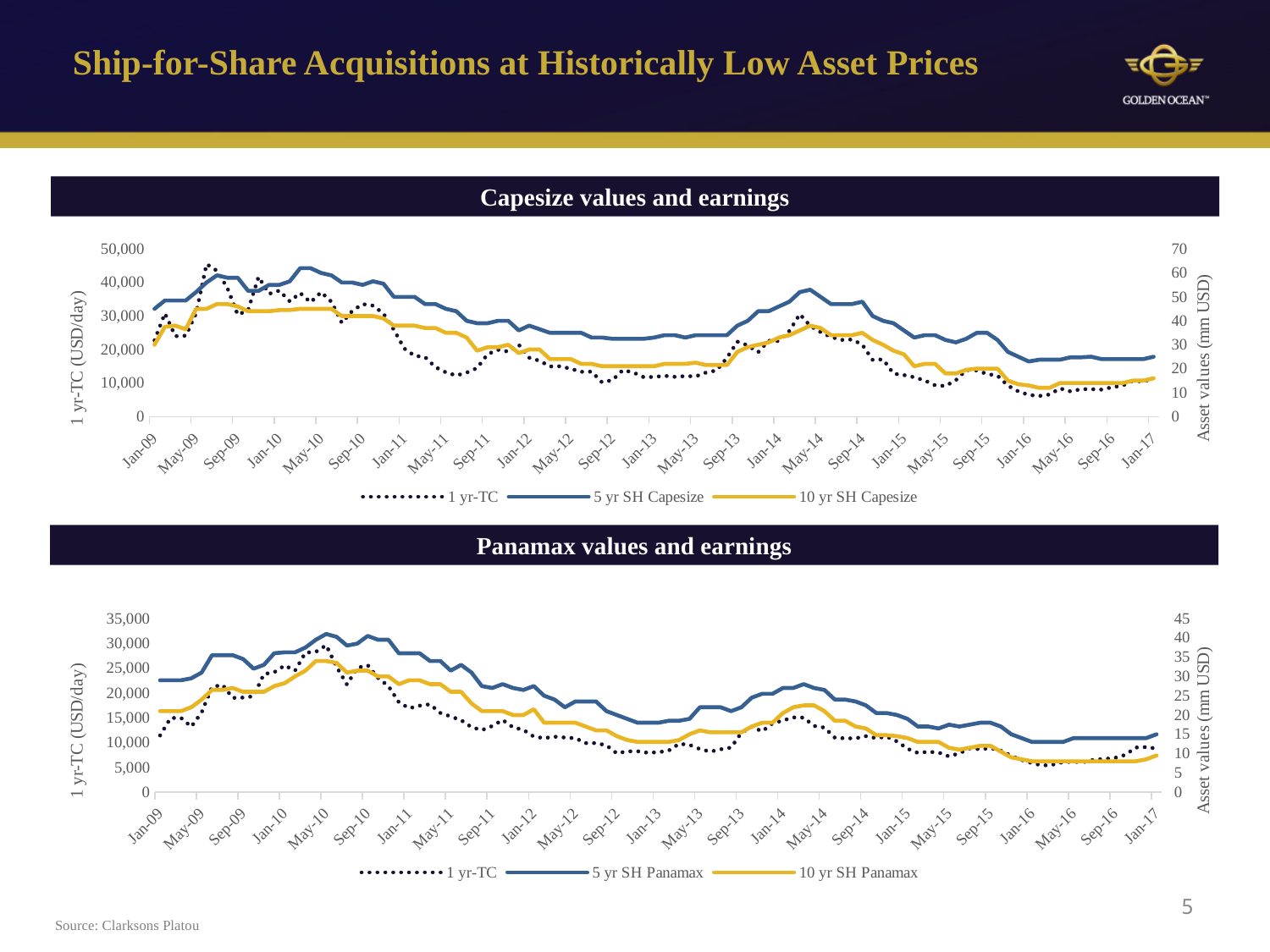
In the "Capesize values and earnings" chart, which series is plotted as a dotted line? 1 yr-TC In the "Capesize values and earnings" chart, does the 5 yr SH Capesize series rise or fall between May-10 and Jan-16? Fall In the "Panamax values and earnings" chart, which series is higher at May-14: 5 yr SH Panamax or 10 yr SH Panamax? 5 yr SH Panamax In the "Capesize values and earnings" chart, is the 1 yr-TC value at Jan-16 greater or less than 10,000 USD/day? less In the "Panamax values and earnings" chart, does the 10 yr SH Panamax series rise or fall between Jan-09 and May-10? Rise What is the label of the right-hand vertical axis on the "Panamax values and earnings" chart? Asset values (mm USD) In the "Panamax values and earnings" chart, is the 5 yr SH Panamax value at Jan-17 greater or less than 30 on the right-hand axis? less In the "Capesize values and earnings" chart, which series is higher at Jan-17: 5 yr SH Capesize or 10 yr SH Capesize? 5 yr SH Capesize What kind of chart is the "Capesize values and earnings" chart? Line chart How many series does the legend of the "Panamax values and earnings" chart list? 3 In the "Panamax values and earnings" chart, is the 1 yr-TC value at its peak around May-10 greater or less than 25,000 USD/day? greater